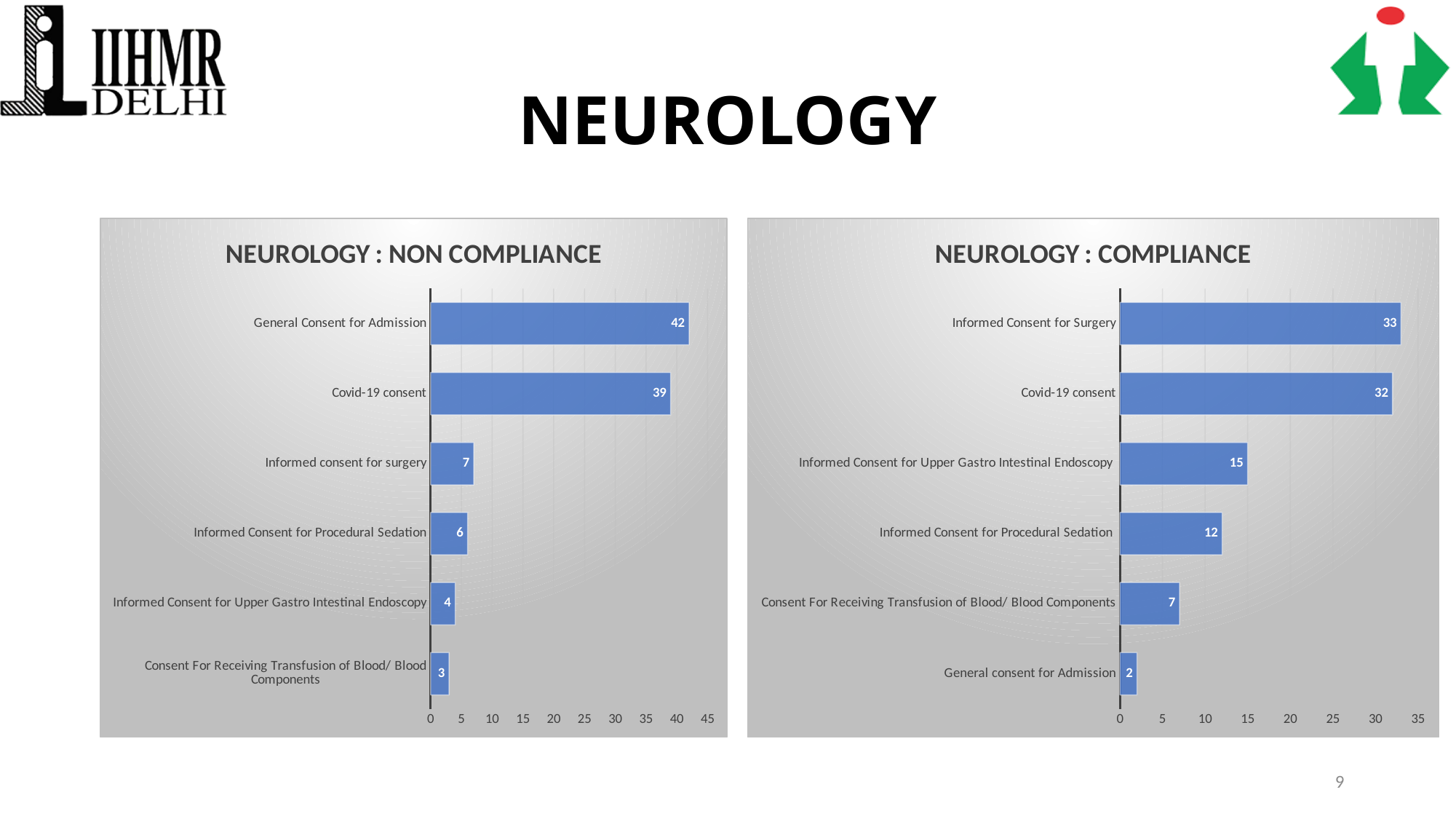
In the NEUROLOGY : NON COMPLIANCE chart, which category has the lowest value? Consent For Receiving Transfusion of Blood/ Blood Components In the NEUROLOGY : NON COMPLIANCE chart, what is the difference between the values for General Consent for Admission and Covid-19 consent? 3 What kind of chart is the NEUROLOGY : NON COMPLIANCE chart? Bar chart In the NEUROLOGY : COMPLIANCE chart, what is the value for Informed Consent for Upper Gastro Intestinal Endoscopy? 15 In the NEUROLOGY : COMPLIANCE chart, what is the difference between the values for Informed Consent for Procedural Sedation and General consent for Admission? 10 In the NEUROLOGY : NON COMPLIANCE chart, what is the value for Informed Consent for Procedural Sedation? 6 In the NEUROLOGY : NON COMPLIANCE chart, what is the value for General Consent for Admission? 42 In the NEUROLOGY : COMPLIANCE chart, which category has the highest value? Informed Consent for Surgery In the NEUROLOGY : NON COMPLIANCE chart, is the value for Covid-19 consent greater or less than 35? greater What is the title of the chart on the right side of the slide? NEUROLOGY : COMPLIANCE In the NEUROLOGY : COMPLIANCE chart, which is larger: the value for Covid-19 consent or the value for Informed Consent for Procedural Sedation? Covid-19 consent How many categories are shown in the NEUROLOGY : COMPLIANCE chart? 6